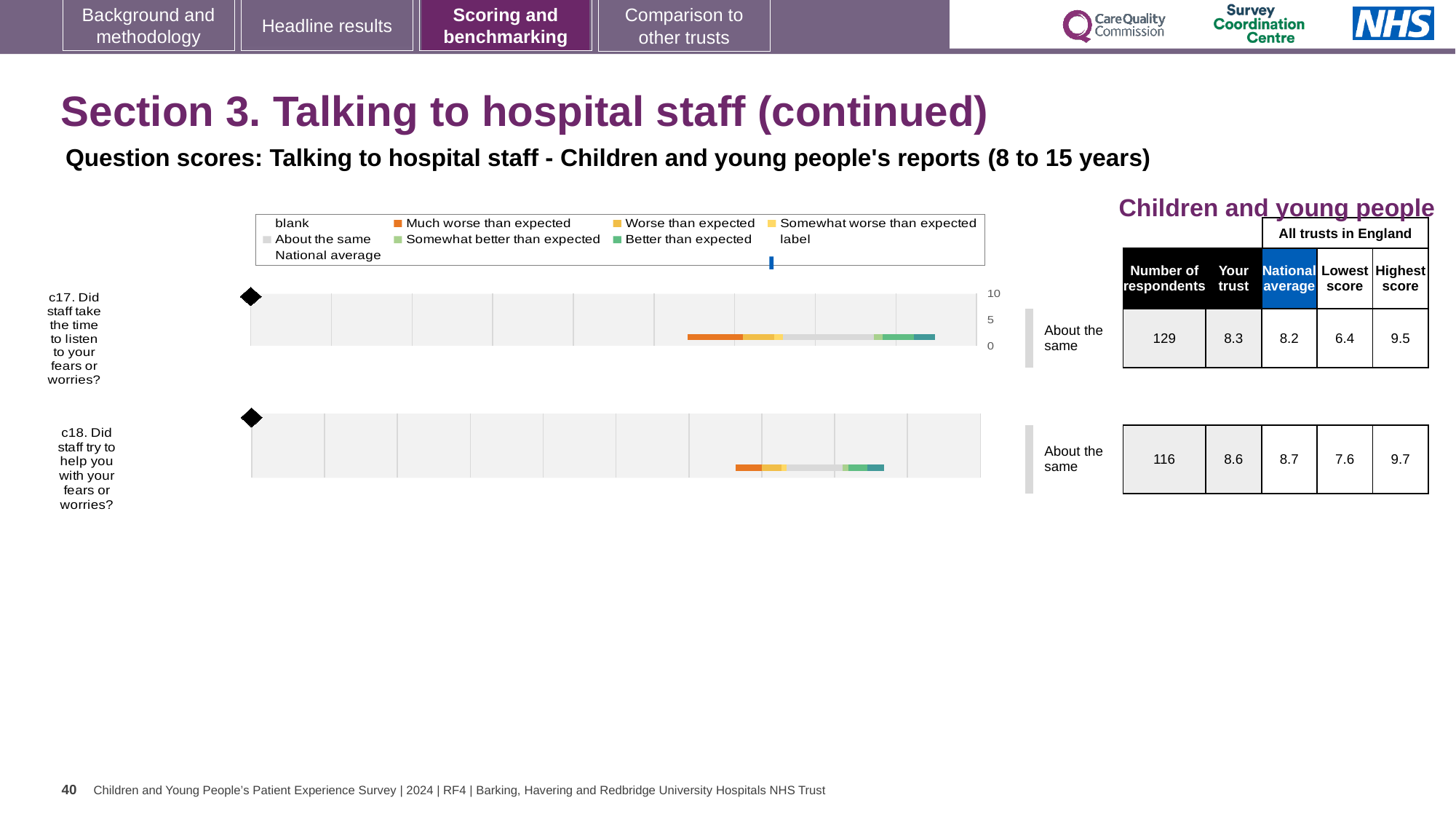
What kind of chart is used to show the question scores for c17 and c18? bar chart What benchmark category is shown for c18? About the same How many survey questions are plotted on the slide? 2 How many respondents answered question c17? 129 What is the national average score for c18 (Did staff try to help you with your fears or worries?)? 8.7 Which question has the higher trust score, c17 or c18? c18 What is the lowest score across all trusts in England for c18? 7.6 For c17, is the trust's score higher or lower than the national average? higher What is the difference between the highest and lowest scores for c18? 2.1 What is the highest score across all trusts in England for c17? 9.5 How many more respondents answered c17 than c18? 13 What is the trust's score for c17 (Did staff take the time to listen to your fears or worries?)? 8.3